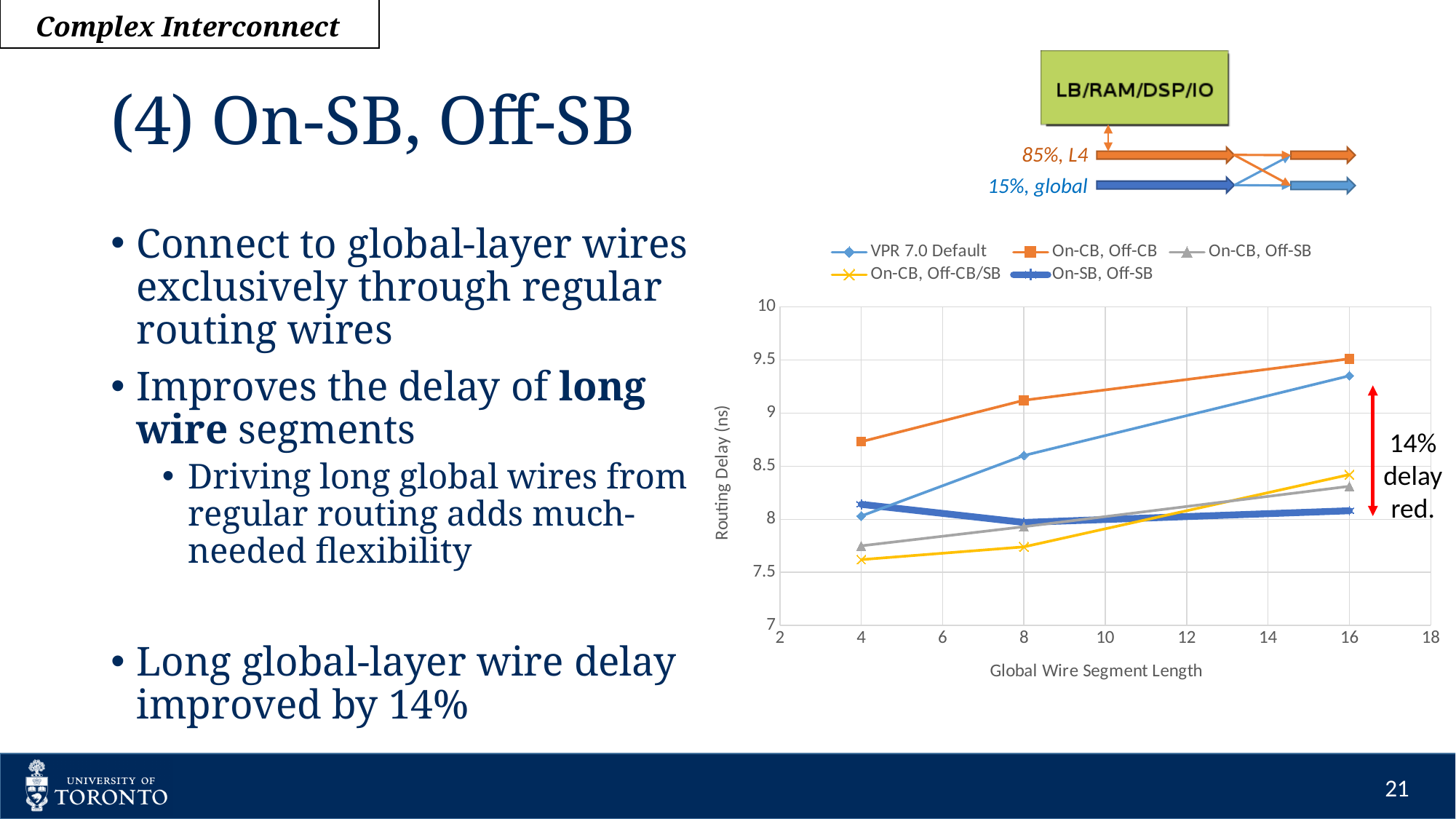
How many data points are plotted for the VPR 7.0 Default series? 3 Is the routing delay for On-SB, Off-SB at segment length 16 greater or less than 8.5? less Is the routing delay for On-CB, Off-CB/SB at segment length 4 greater or less than 8? less Does the routing delay for the On-CB, Off-CB series rise or fall as global wire segment length increases? rise How many series does the chart legend list? 5 Is the routing delay for VPR 7.0 Default at segment length 16 greater or less than 9? greater Which series has the highest routing delay at a global wire segment length of 16? On-CB, Off-CB At segment length 4, which has the larger routing delay: VPR 7.0 Default or On-CB, Off-CB? On-CB, Off-CB Which series has the lowest routing delay at a global wire segment length of 4? On-CB, Off-CB/SB What kind of chart is shown on the slide? line chart Which series has the lowest routing delay at a global wire segment length of 16? On-SB, Off-SB What is the label of the chart's y axis? Routing Delay (ns)